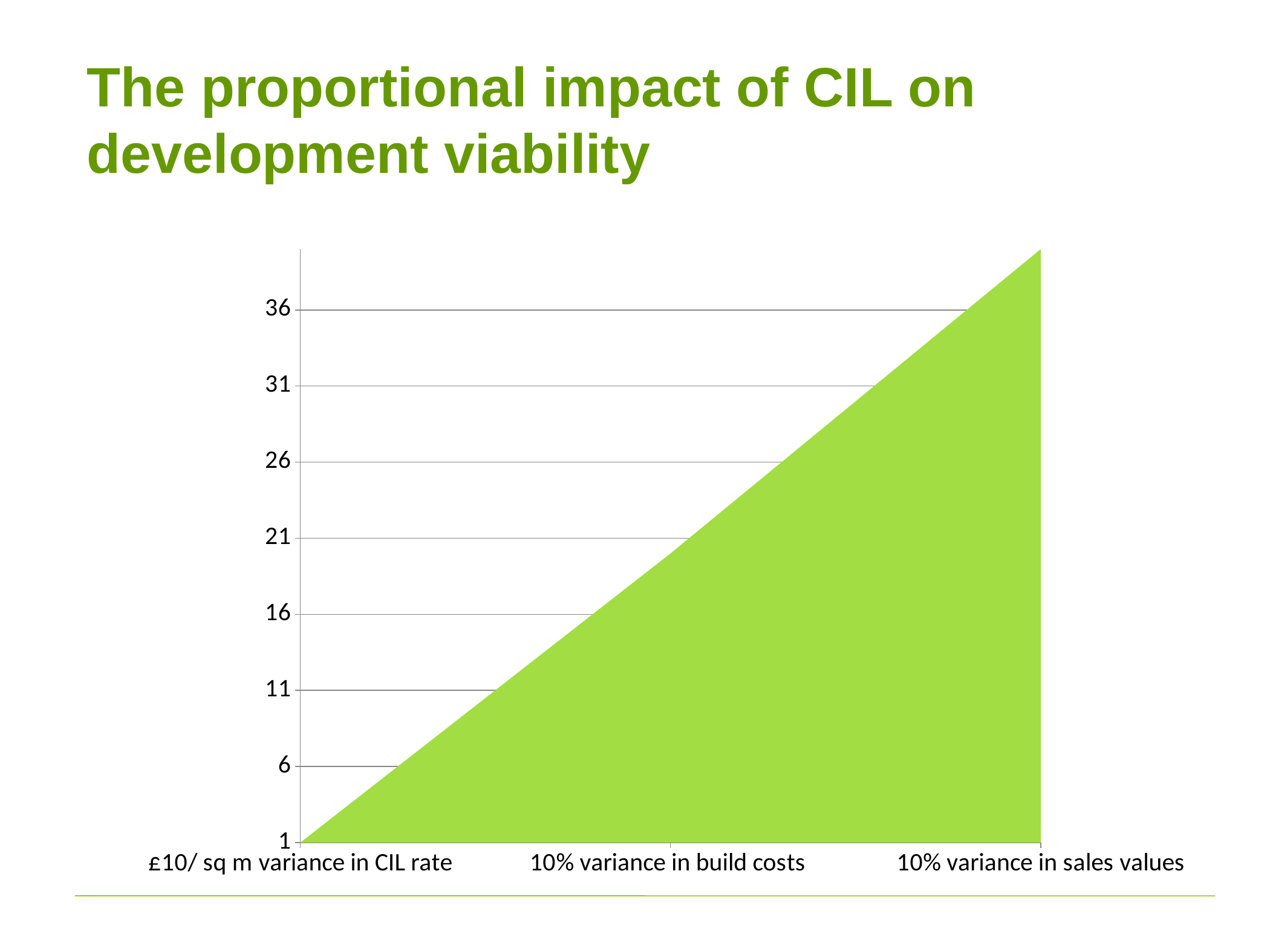
What is the value for £10/ sq m variance in CIL rate? 1 Is the value for 10% variance in build costs greater or less than 16? greater Is the value for 10% variance in build costs greater or less than 26? less What is the title of the slide containing the chart? The proportional impact of CIL on development viability Which is larger, the value for 10% variance in build costs or the value for £10/ sq m variance in CIL rate? 10% variance in build costs Which category has the lowest value? £10/ sq m variance in CIL rate Which category has the highest value? 10% variance in sales values What colour is the filled area in the chart? green Is the value for 10% variance in sales values greater or less than 36? greater What kind of chart is shown on the slide? area chart How many categories are plotted along the x axis? 3 Do the values rise or fall moving from left to right along the x axis? rise